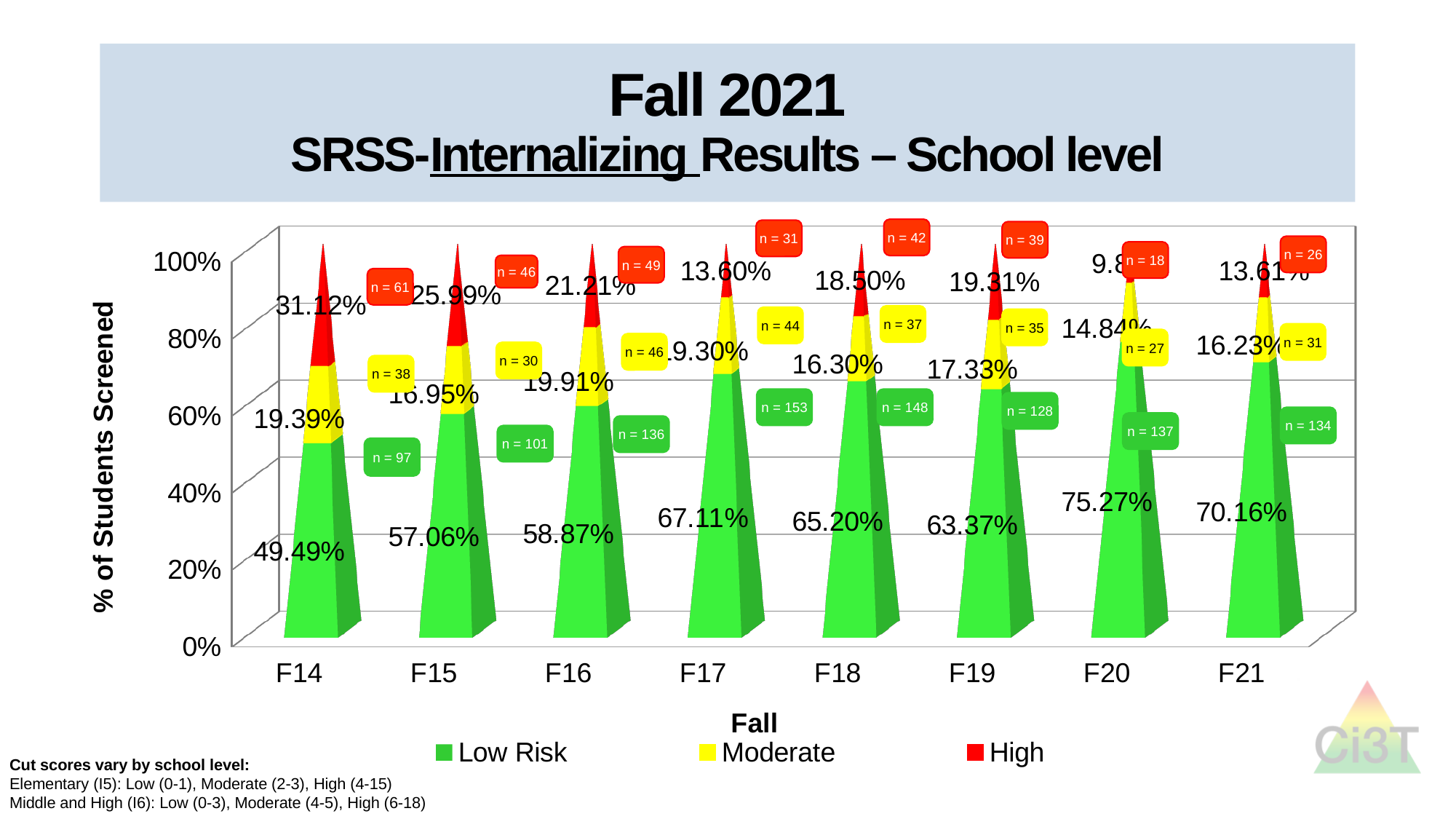
What is the High percentage for F14? 31.12% How many series does the legend list? 3 What is the Moderate percentage for F16? 19.91% Which fall has the highest High percentage? F14 How many fall periods are shown on the x axis? 8 What is the difference between the Low Risk percentage for F21 and for F14? 20.67% Which fall has the highest Low Risk percentage? F20 What is the Low Risk percentage for F14? 49.49% What is the n value shown for the Low Risk group in F17? n = 153 Which has a larger Low Risk percentage, F17 or F18? F17 Does the Low Risk percentage rise or fall from F14 to F17? rise Which fall has the lowest Low Risk percentage? F14